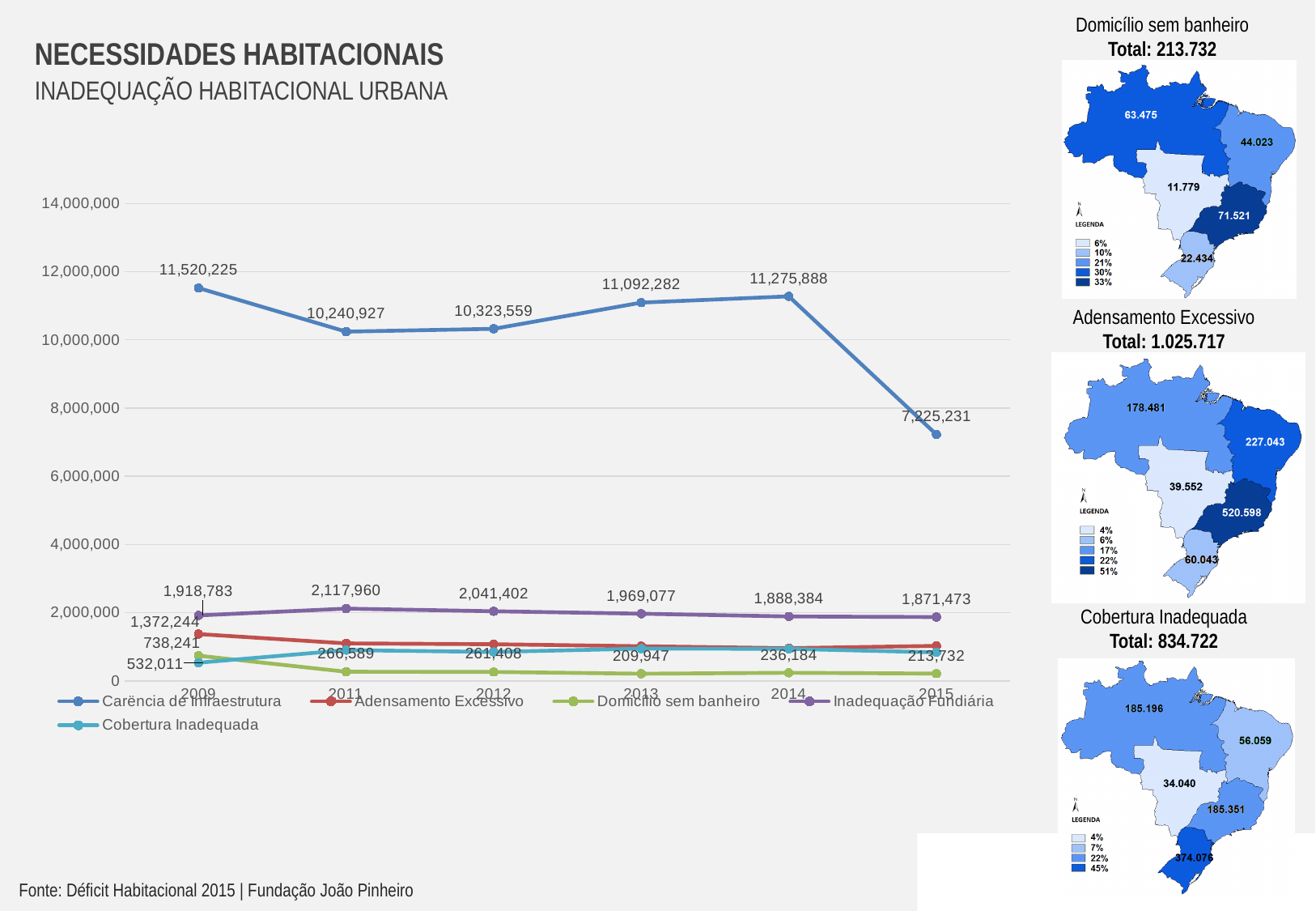
How many series does the legend of the line chart list? 5 In which year is Carência de Infraestrutura at its lowest? 2015 What is the difference between Carência de Infraestrutura in 2014 and in 2015? 4,050,657 What is the value of Carência de Infraestrutura in 2015? 7,225,231 Which series has the highest values across all years in the line chart? Carência de Infraestrutura What type of chart is the main chart on the left of the slide? line chart What is the value of Carência de Infraestrutura in 2009? 11,520,225 In which year is Inadequação Fundiária at its highest? 2011 Does Inadequação Fundiária rise or fall from 2011 to 2015? fall What is the value of Inadequação Fundiária in 2011? 2,117,960 How many years are shown on the x axis of the line chart? 6 Is the value of Carência de Infraestrutura in 2013 greater or less than 10,000,000? greater